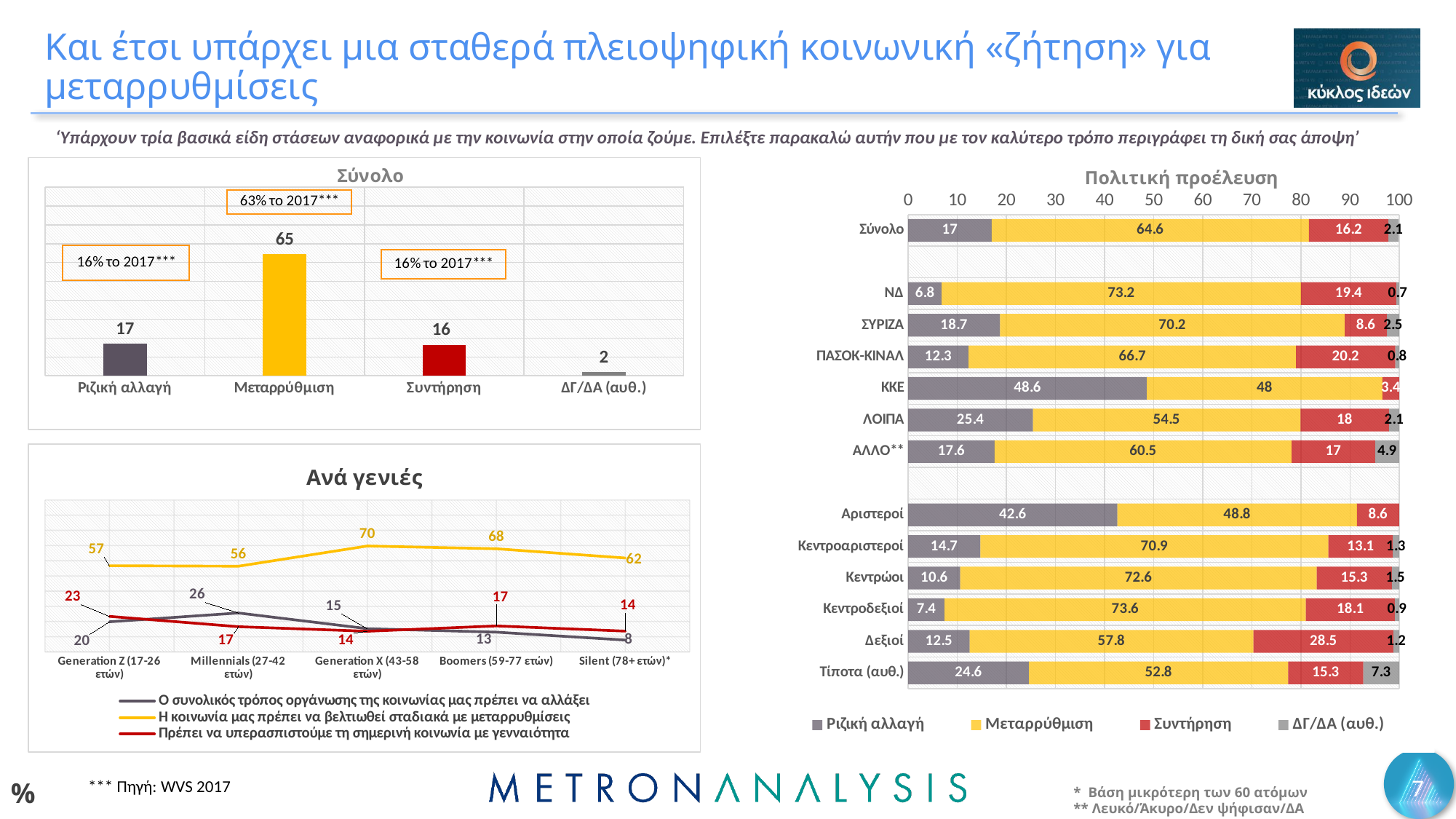
In the 'Σύνολο' chart, which category has the lowest value? ΔΓ/ΔΑ (αυθ.) In the 'Σύνολο' chart, what is the value for Μεταρρύθμιση? 65 In the 'Σύνολο' chart, how many categories are shown on the x axis? 4 In the 'Ανά γενιές' chart, how many series does the legend list? 3 In the 'Ανά γενιές' chart, what is the value of the yellow line for Generation X (43-58 ετών)? 70 In the 'Σύνολο' chart, what is the difference between Ριζική αλλαγή and Συντήρηση? 1 In the 'Πολιτική προέλευση' chart, which is larger: the Συντήρηση value for Δεξιοί or for ΣΥΡΙΖΑ? Δεξιοί In the 'Πολιτική προέλευση' chart, what is the difference between the Ριζική αλλαγή values for Αριστεροί and Κεντροαριστεροί? 27.9 In the 'Πολιτική προέλευση' chart, what is the Μεταρρύθμιση value for ΝΔ? 73.2 In the 'Ανά γενιές' chart, does the grey line ('Ο συνολικός τρόπος οργάνωσης της κοινωνίας μας πρέπει να αλλάξει') rise or fall from Millennials (27-42 ετών) to Silent (78+ ετών)*? Fall What kind of chart is 'Ανά γενιές'? Line chart In the 'Πολιτική προέλευση' chart, which category has the highest Ριζική αλλαγή value? ΚΚΕ